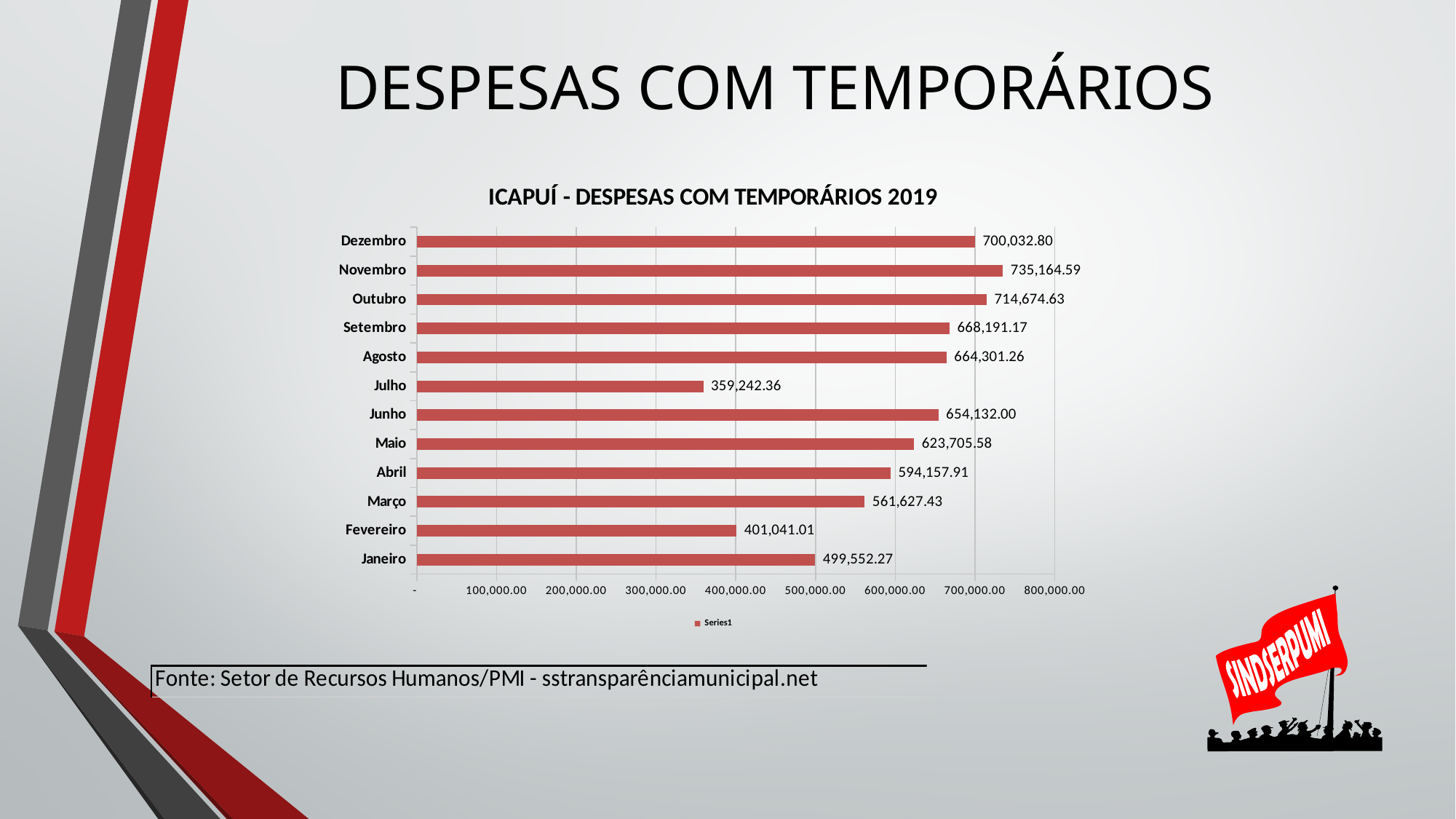
What is the title of the chart? ICAPUÍ - DESPESAS COM TEMPORÁRIOS 2019 How many months are shown in the chart? 12 What is the value for Novembro? 735,164.59 What is the difference between the values for Novembro and Dezembro? 35,131.79 What is the value for Janeiro? 499,552.27 What is the difference between the values for Janeiro and Fevereiro? 98,511.26 Which is larger, the value for Outubro or the value for Setembro? Outubro Which month has the lowest value? Julho Which month has the highest value? Novembro Is the value for Março greater or less than 500,000.00? greater What is the value for Julho? 359,242.36 What kind of chart is shown on the slide? bar chart